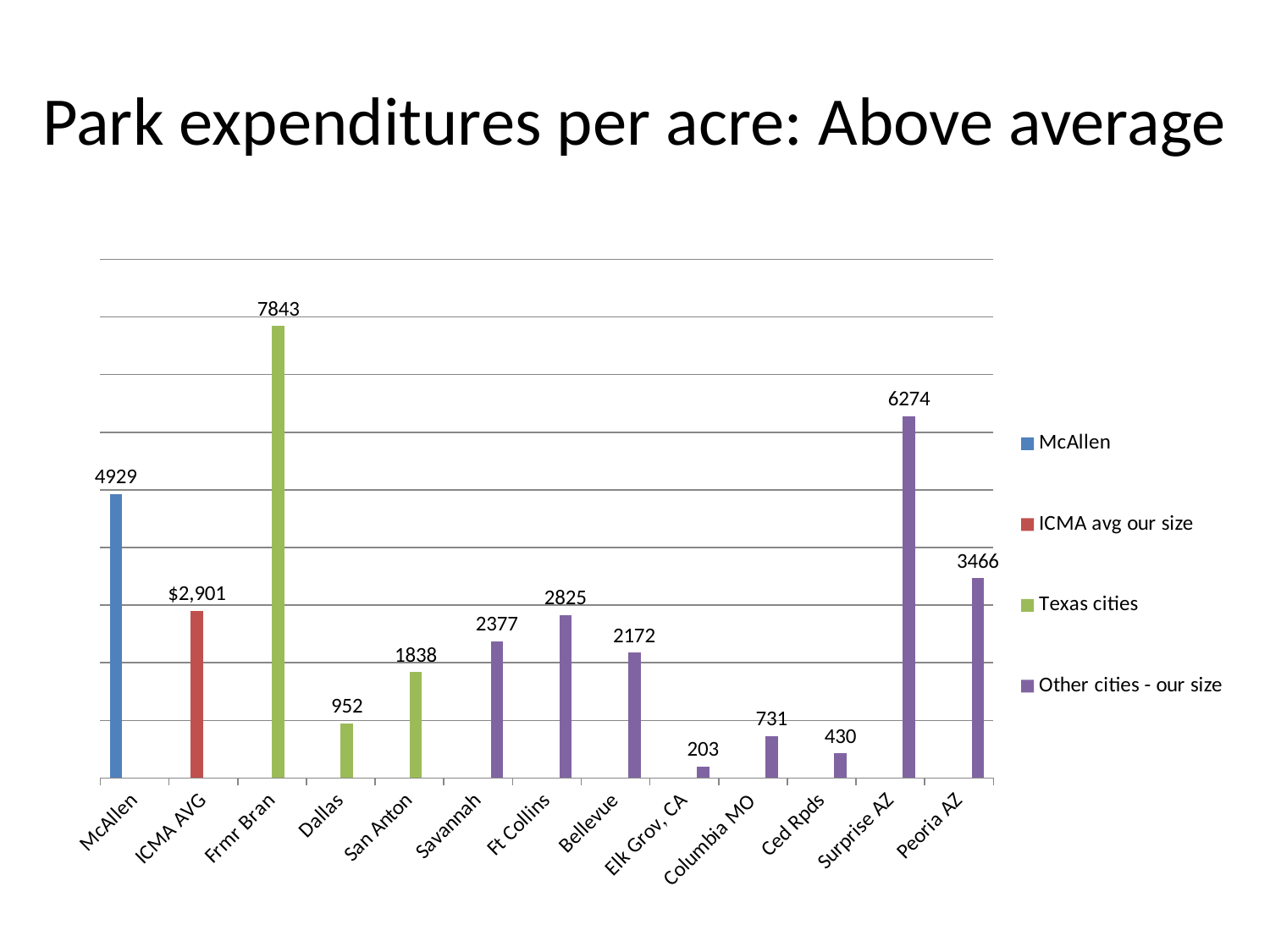
What is the difference between the values for Frmr Bran and Surprise AZ? 1569 What is the value for Surprise AZ? 6274 Which is larger, the value for Savannah or the value for San Anton? Savannah How many series does the legend list? 4 What is the value for ICMA AVG? $2,901 Which category has the lowest value? Elk Grov, CA Which category has the highest value? Frmr Bran How many categories are shown on the x axis? 13 What is the value for McAllen? 4929 What is the difference between the values for Ft Collins and Bellevue? 653 What is the title of the slide? Park expenditures per acre: Above average What kind of chart is shown on the slide? Bar chart